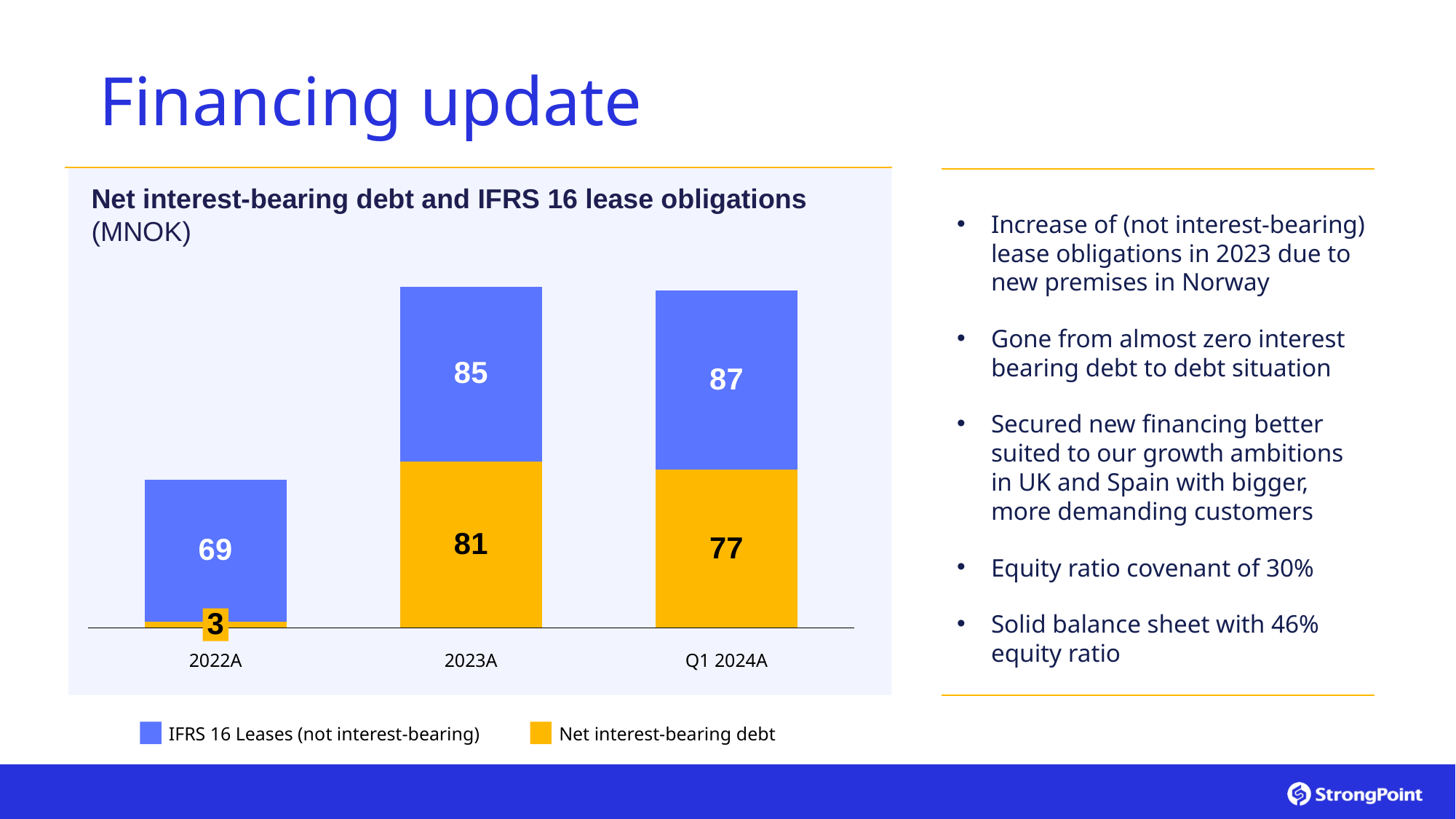
What is the total of the stacked bar for 2023A? 166 Which is larger: IFRS 16 Leases in 2023A or IFRS 16 Leases in Q1 2024A? IFRS 16 Leases in Q1 2024A What is the value of IFRS 16 Leases (not interest-bearing) for 2022A? 69 Which period has the highest value for IFRS 16 Leases (not interest-bearing)? Q1 2024A What is the value of Net interest-bearing debt for 2022A? 3 What is the value of Net interest-bearing debt for Q1 2024A? 77 Which period has the lowest value for Net interest-bearing debt? 2022A How many series does the legend list? 2 How many periods are shown on the x axis? 3 What is the value of IFRS 16 Leases (not interest-bearing) for 2023A? 85 What is the difference between the Net interest-bearing debt in 2023A and in Q1 2024A? 4 What kind of chart is shown on the slide? Stacked bar chart